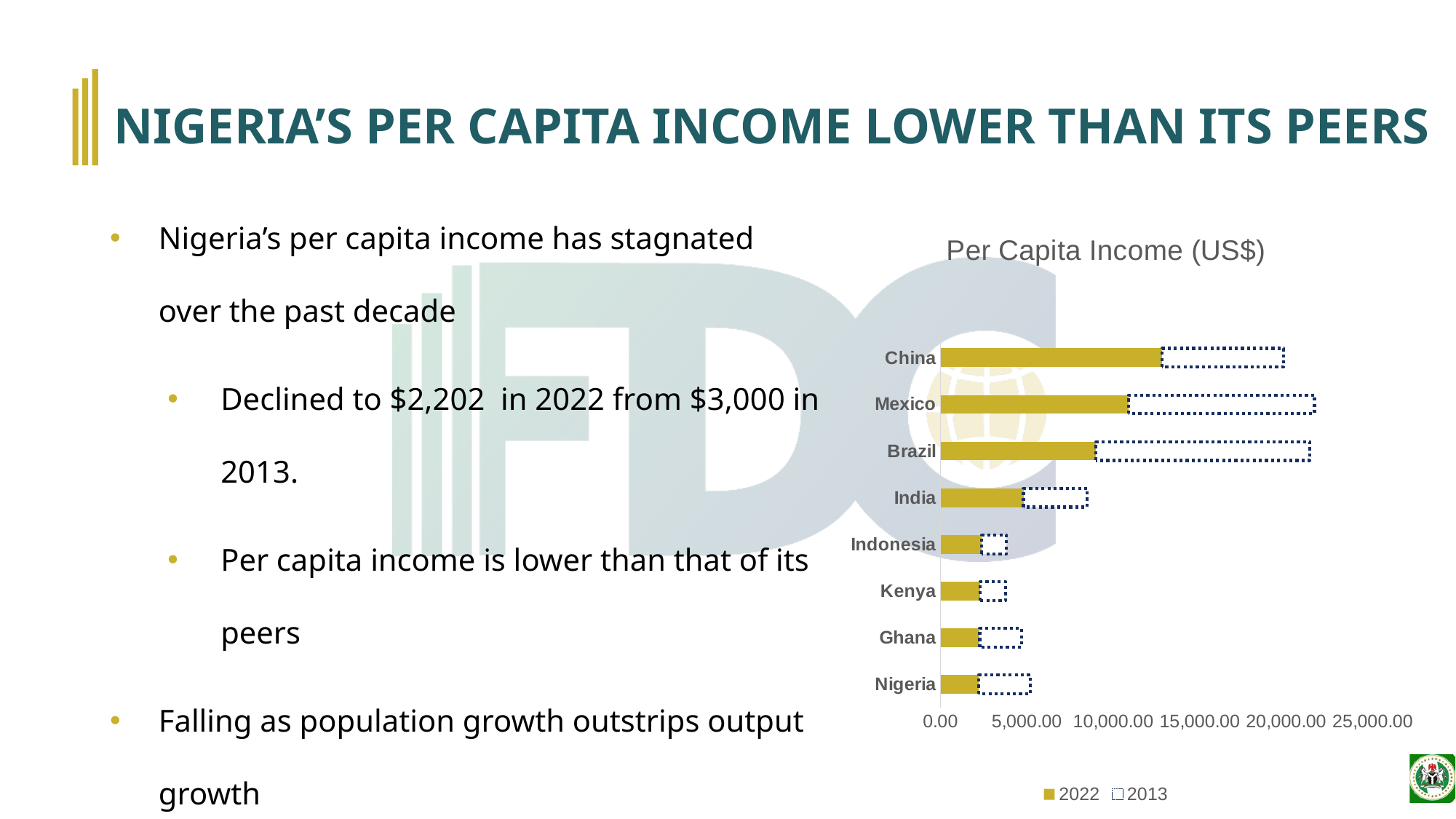
How many series does the chart legend list? 2 Is the 2022 per capita income for Nigeria greater or less than 5,000.00? less Is the 2022 per capita income for Brazil greater or less than 10,000.00? less Which two years are shown in the chart legend? 2022 and 2013 Which country is listed at the bottom of the chart? Nigeria What is the title of the chart? Per Capita Income (US$) Which has the larger 2022 per capita income, Mexico or India? Mexico Which has the larger 2022 per capita income, China or Brazil? China Is the 2022 per capita income for China greater or less than 10,000.00? greater How many countries are listed on the chart? 8 What type of chart is shown on the slide? Bar chart Which country has the highest 2022 per capita income on the chart? China